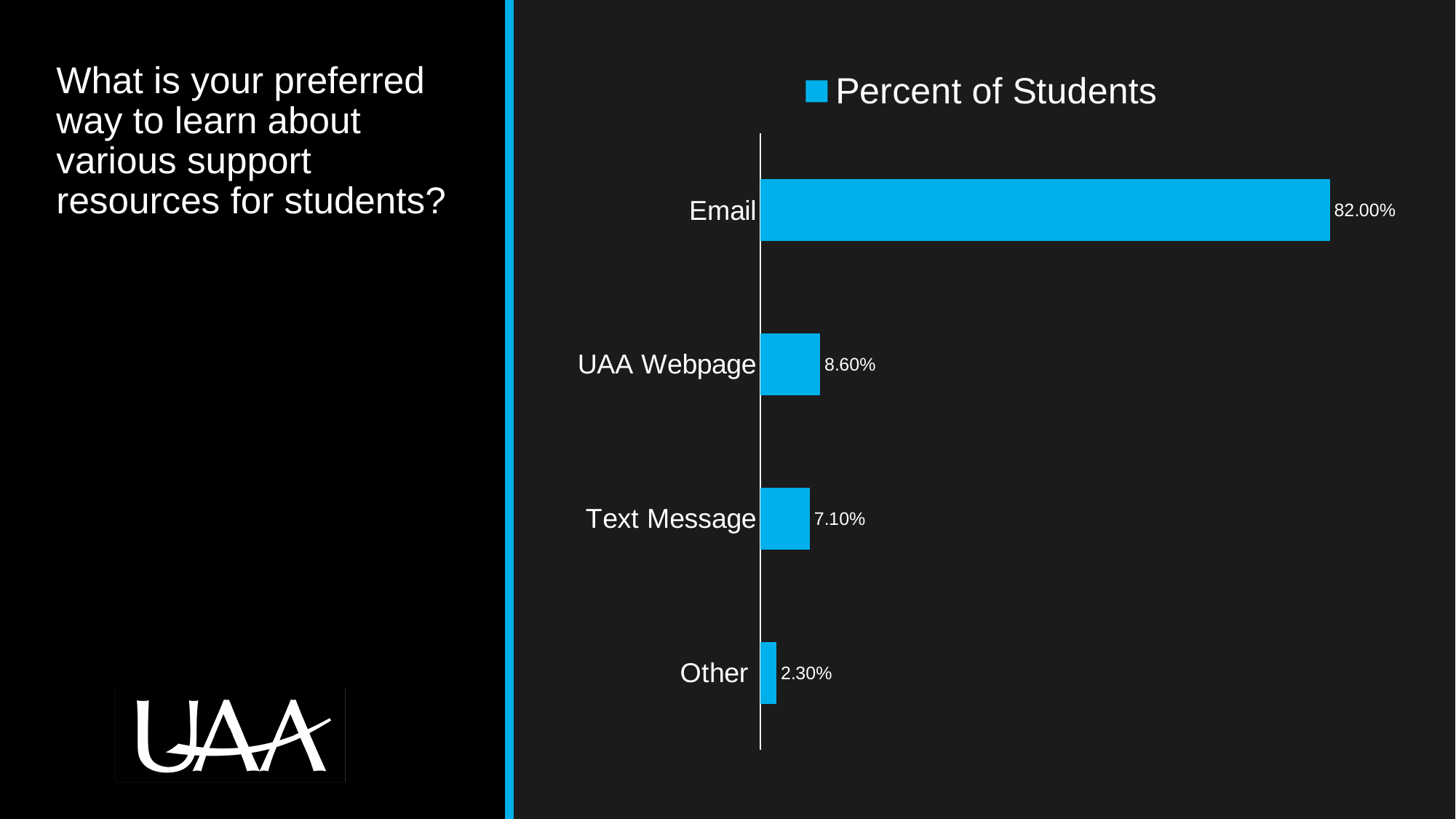
What is the value for Email? 82.00% How many series does the legend list? 1 What is the value for Text Message? 7.10% What is the value for Other? 2.30% Which category has the lowest percent of students? Other What is the difference between the values for Email and UAA Webpage? 73.40% How many categories are shown in the chart? 4 What kind of chart is shown on the slide? Bar chart Which category has the highest percent of students? Email What is the value for UAA Webpage? 8.60% Which is larger, the value for Text Message or the value for Other? Text Message What is the difference between the values for UAA Webpage and Text Message? 1.50%